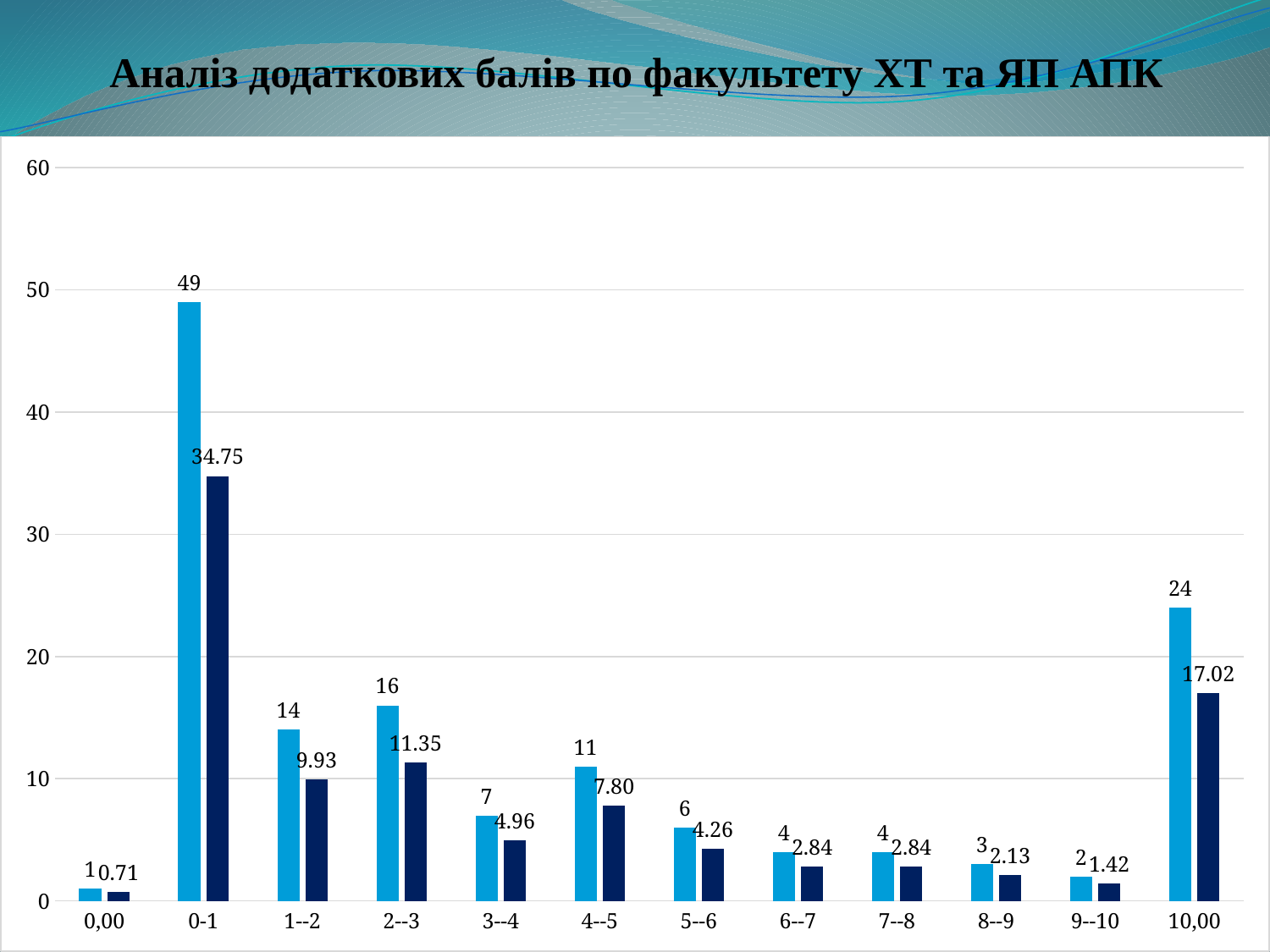
What is the value of the dark blue bar for the category 2--3? 11.35 Is the value of the dark blue bar for 0-1 greater or less than 30? greater What kind of chart is shown on the slide? bar chart Which category has the lowest dark blue bar? 0,00 Do the light blue bars rise or fall from the category 2--3 to the category 9--10? fall Which category has the highest light blue bar? 0-1 Which is larger: the light blue bar for 1--2 or the light blue bar for 2--3? 2--3 What is the title of the slide? Аналіз додаткових балів по факультету ХТ та ЯП АПК What is the difference between the light blue bars for 0-1 and 10,00? 25 What is the value of the dark blue bar for the category 10,00? 17.02 What is the value of the light blue bar for the category 0-1? 49 How many categories are shown on the x axis? 12